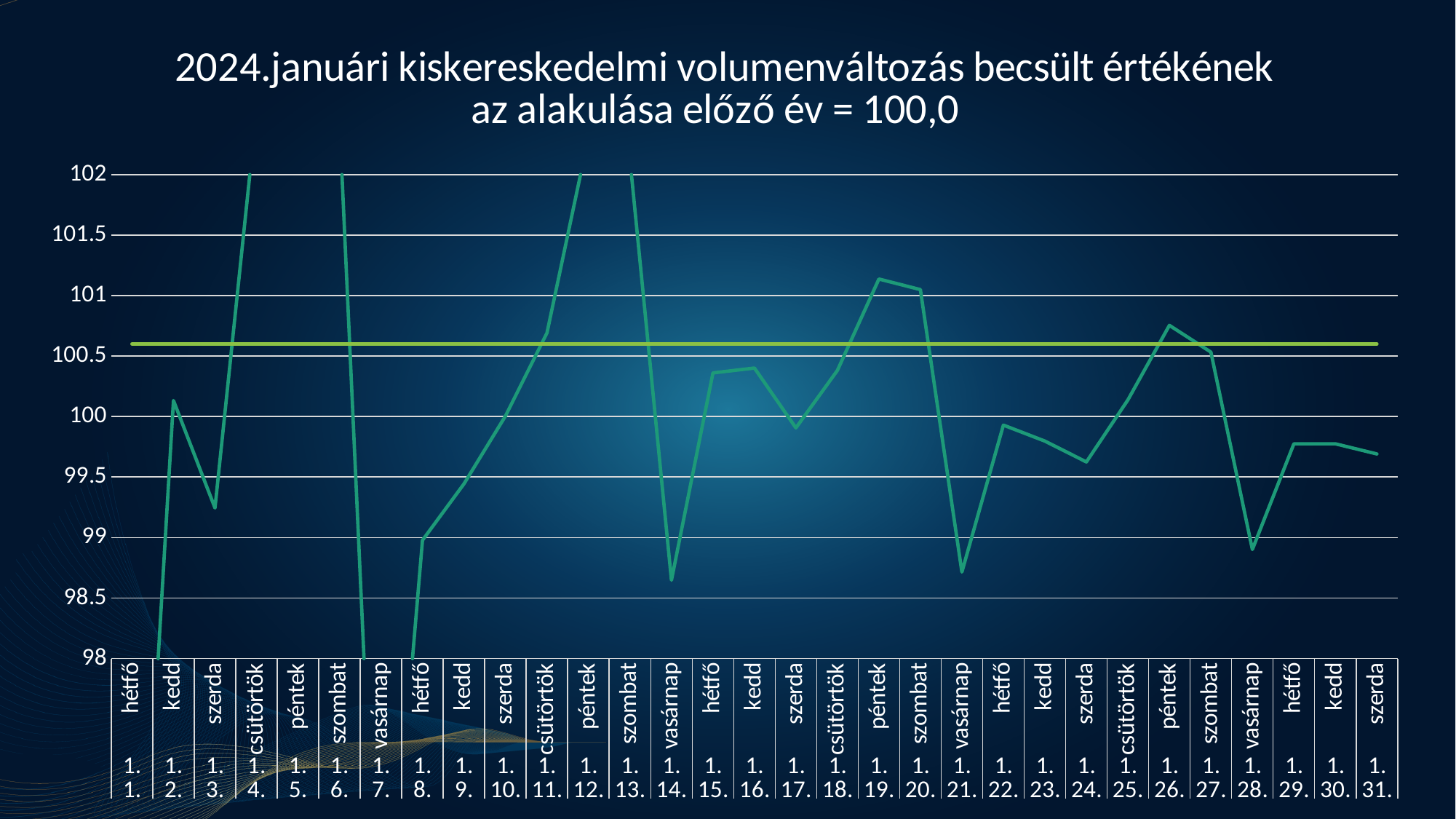
Which has the larger value, 1. 19. (péntek) or 1. 14. (vasárnap)? 1. 19. (péntek) How many days (data points) are shown along the x axis? 31 What is the title of the chart? 2024.januári kiskereskedelmi volumenváltozás becsült értékének az alakulása előző év = 100,0 Is the value for 1. 26. (péntek) greater or less than 100.5? greater Is the value for 1. 19. (péntek) greater or less than 101? greater Is the value for 1. 21. (vasárnap) greater or less than 99? less What kind of chart is shown on the slide? line chart Which has the larger value, 1. 28. (vasárnap) or 1. 29. (hétfő)? 1. 29. (hétfő)